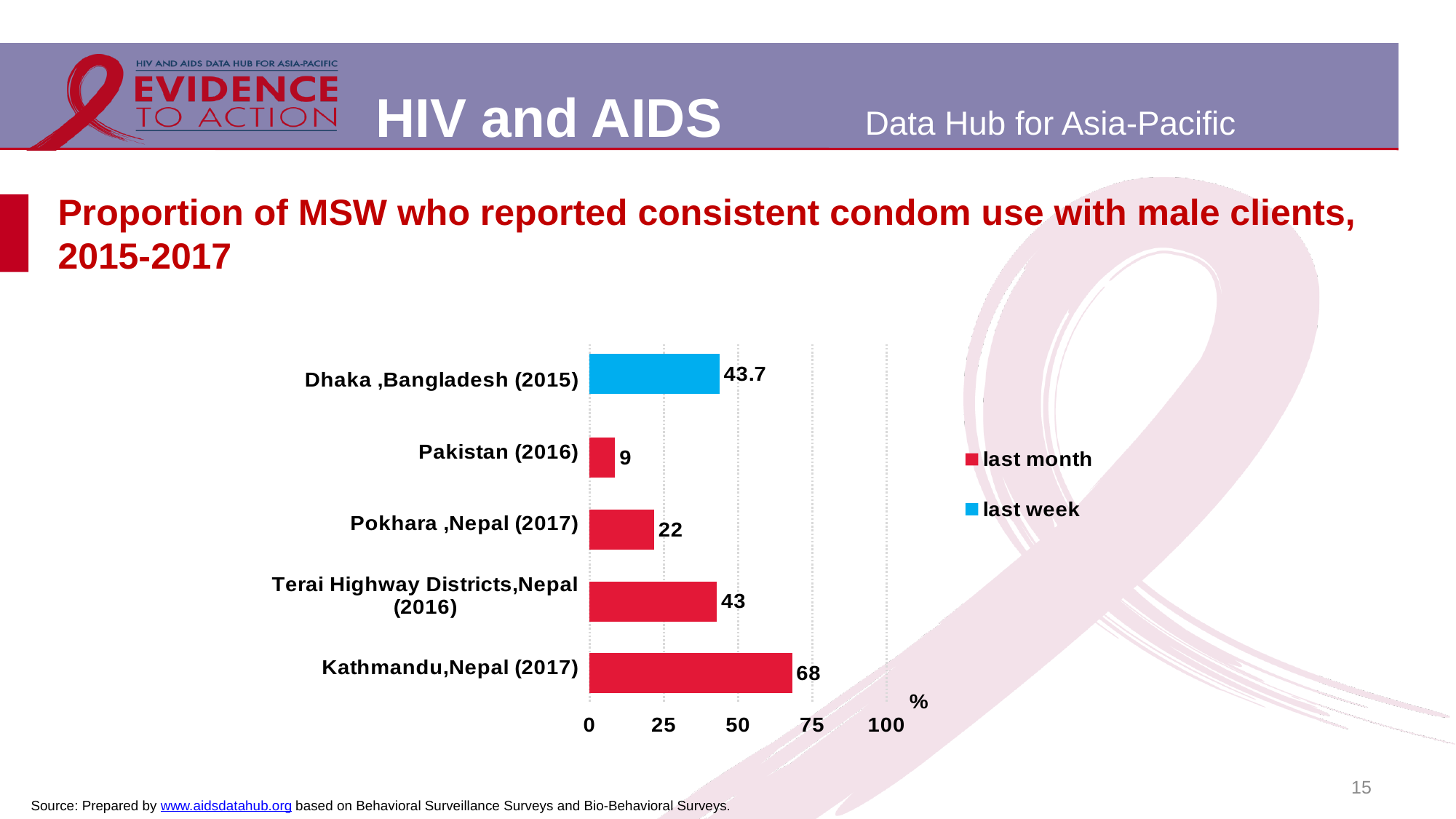
Which is larger, the value for Pokhara ,Nepal (2017) or the value for Terai Highway Districts,Nepal (2016)? Terai Highway Districts,Nepal (2016) Which category has the lowest value? Pakistan (2016) What is the difference between the values for Kathmandu,Nepal (2017) and Pokhara ,Nepal (2017)? 46 What is the value for Pakistan (2016)? 9 Which category has the highest value? Kathmandu,Nepal (2017) How many categories are shown in the chart? 5 How many series does the legend list? 2 Is the value for Kathmandu,Nepal (2017) greater or less than 50? greater What is the value for Terai Highway Districts,Nepal (2016)? 43 What kind of chart is shown on the slide? bar chart What is the value for Dhaka ,Bangladesh (2015)? 43.7 What is the value for Kathmandu,Nepal (2017)? 68